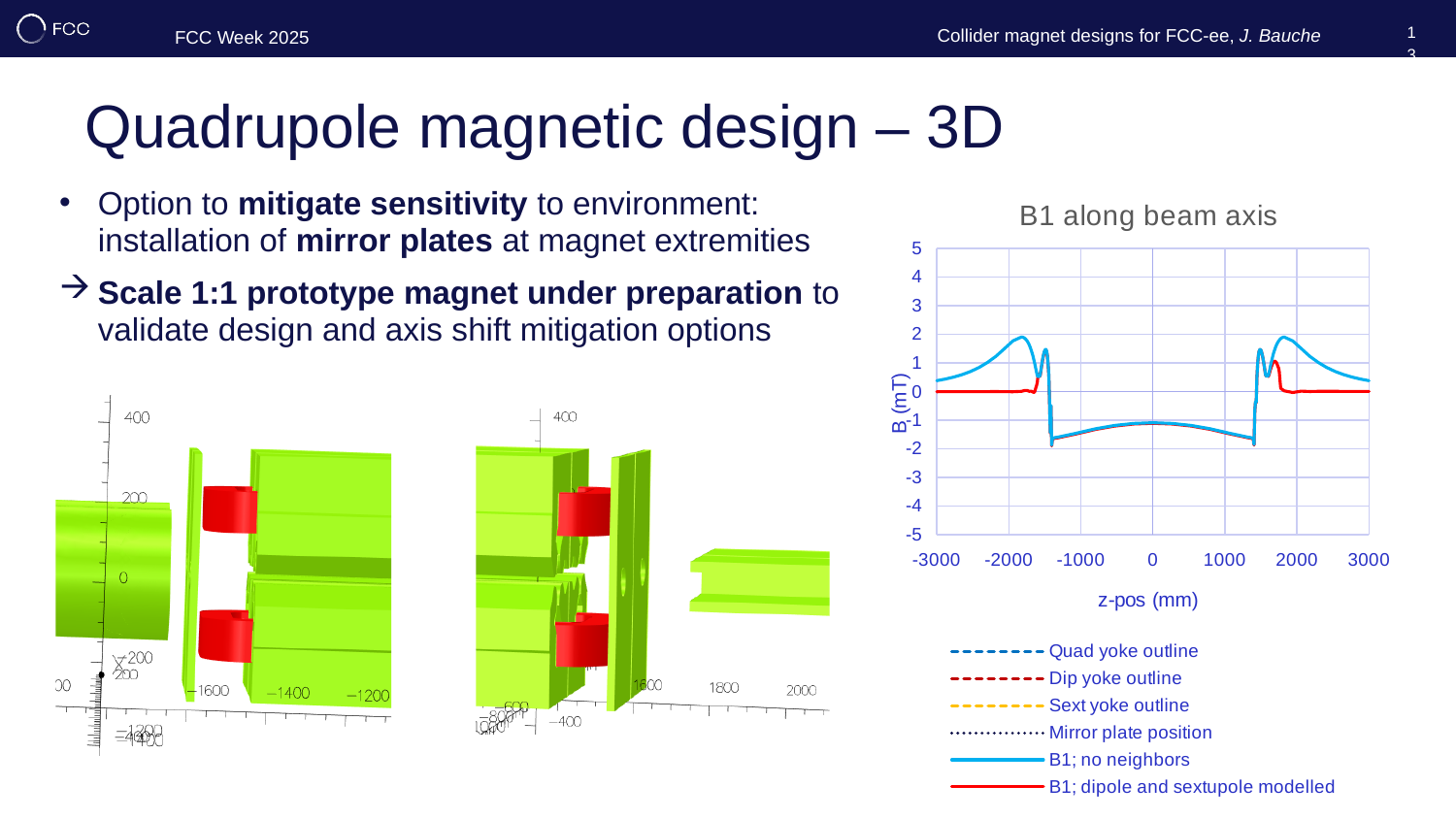
How many tick labels are shown on the chart's x axis? 7 What is the lowest value shown on the chart's x axis? -3000 Is the peak of the 'B1; no neighbors' curve near z-pos -2000 greater or less than 3? less Is the value of the 'B1; dipole and sextupole modelled' curve at z-pos -3000 greater or less than 1? less How many entries does the chart's legend list? 6 Is the value of the 'B1; no neighbors' curve at z-pos 0 greater or less than 0? less What is the label of the chart's x axis? z-pos (mm) What is the title of the chart? B1 along beam axis Which curve reaches a higher peak near z-pos -2000: 'B1; no neighbors' or 'B1; dipole and sextupole modelled'? B1; no neighbors What is the highest value shown on the chart's y axis? 5 What type of chart is shown on the slide? line chart